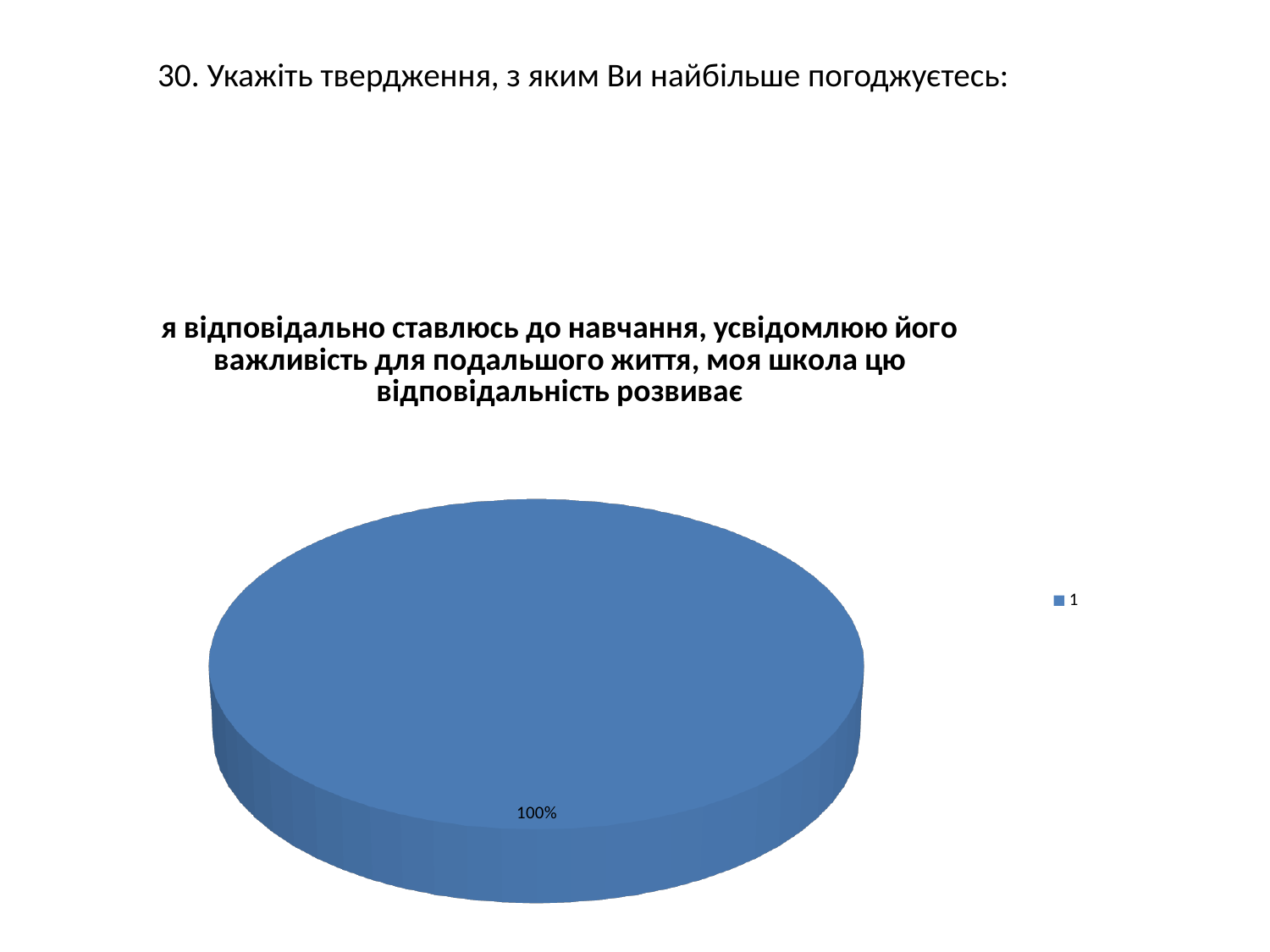
What percentage is shown on the data label of the pie slice? 100% What is the label of the legend entry? 1 Is the value shown on the pie slice greater or less than 50%? greater How many entries does the legend list? 1 What colour is the pie slice? blue How many slices does the pie chart have? 1 What kind of chart is shown on the slide? pie chart What share of the pie does the slice labelled "1" take? 100%